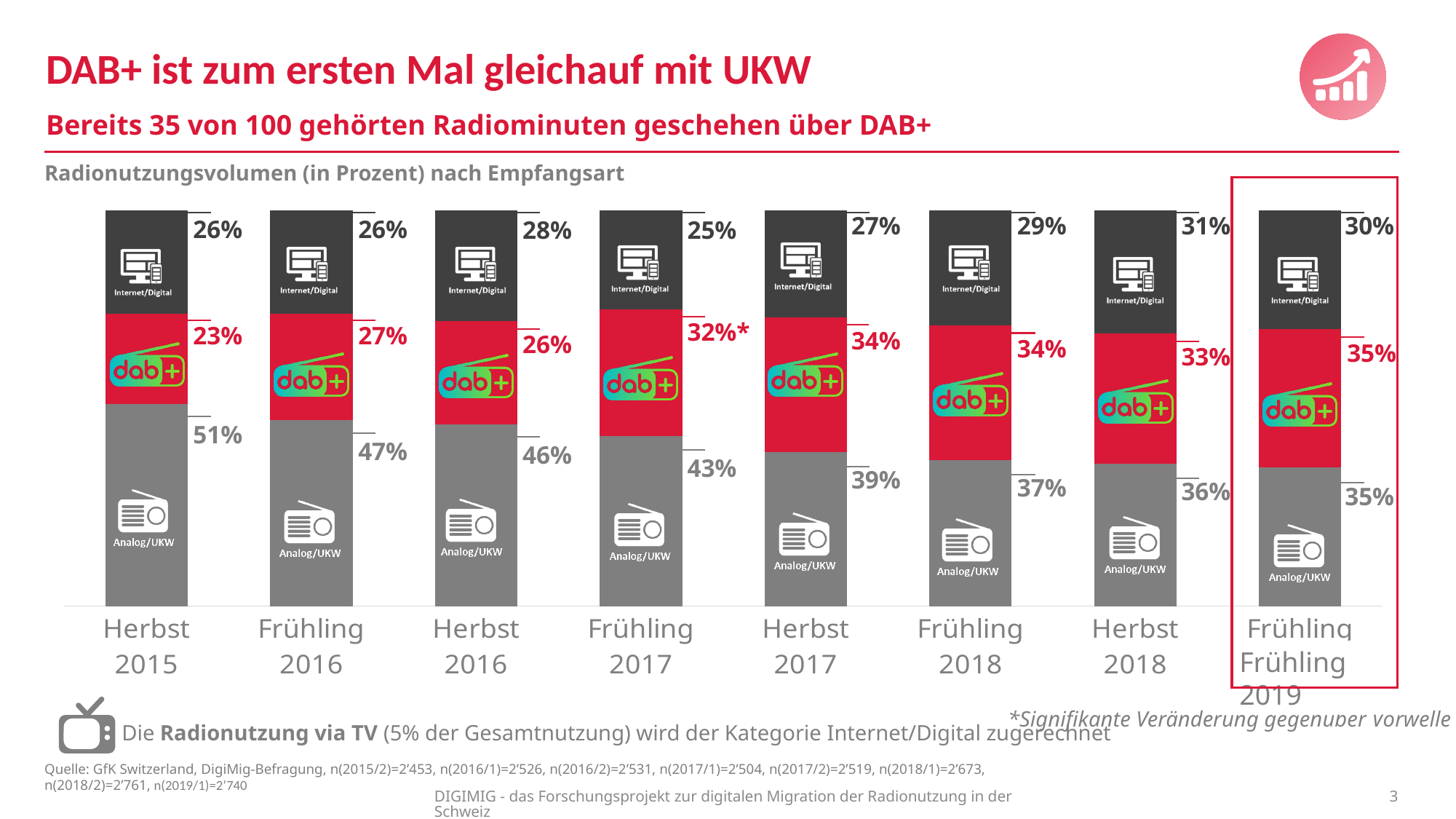
What is the DAB+ share in Frühling 2019? 35% What is the Analog/UKW share in Herbst 2015? 51% Does the Analog/UKW share rise or fall from Herbst 2015 to Frühling 2019? Fall How many periods are shown on the x axis? 8 What kind of chart is shown on the slide? Stacked bar chart In which period is the DAB+ share lowest? Herbst 2015 In Herbst 2017, which is larger: the DAB+ share or the Internet/Digital share? DAB+ What is the DAB+ share in Frühling 2017? 32% What is the difference between the Analog/UKW share in Herbst 2015 and in Frühling 2019? 16% What is the Internet/Digital share in Herbst 2018? 31% In which period is the Analog/UKW share highest? Herbst 2015 What is the title of the chart? Radionutzungsvolumen (in Prozent) nach Empfangsart